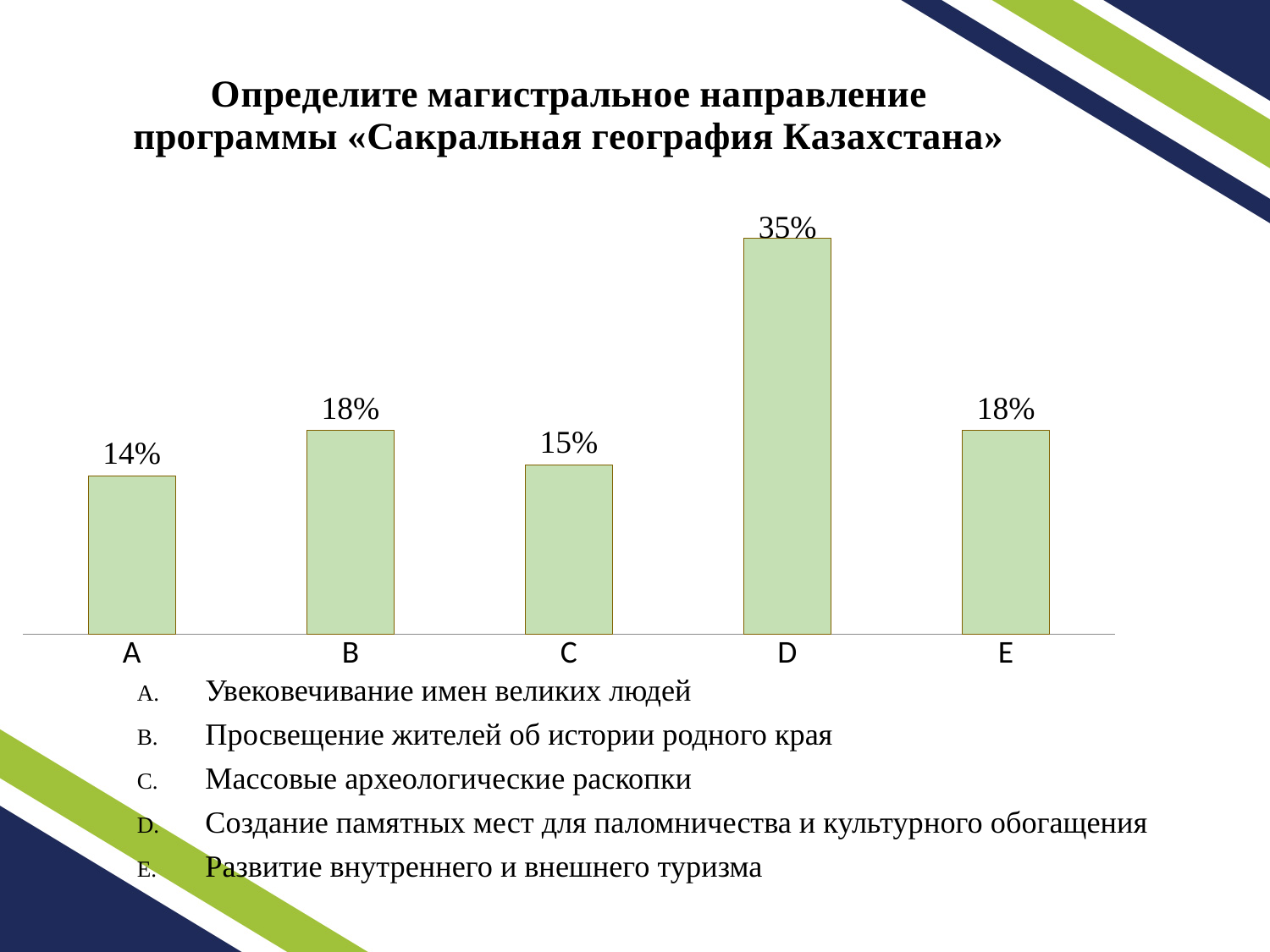
What is the total of the values for A, B and C? 47% What is the value for category D? 35% What is the value for category A? 14% Which is larger, the value for B or the value for C? B What is the difference between the values for C and A? 1% How many categories are shown on the x axis? 5 Which category has the highest value? D Which two categories have the same value? B and E Which category has the lowest value? A What kind of chart is shown on the slide? bar chart What is the difference between the values for D and B? 17% What is the value for category C? 15%